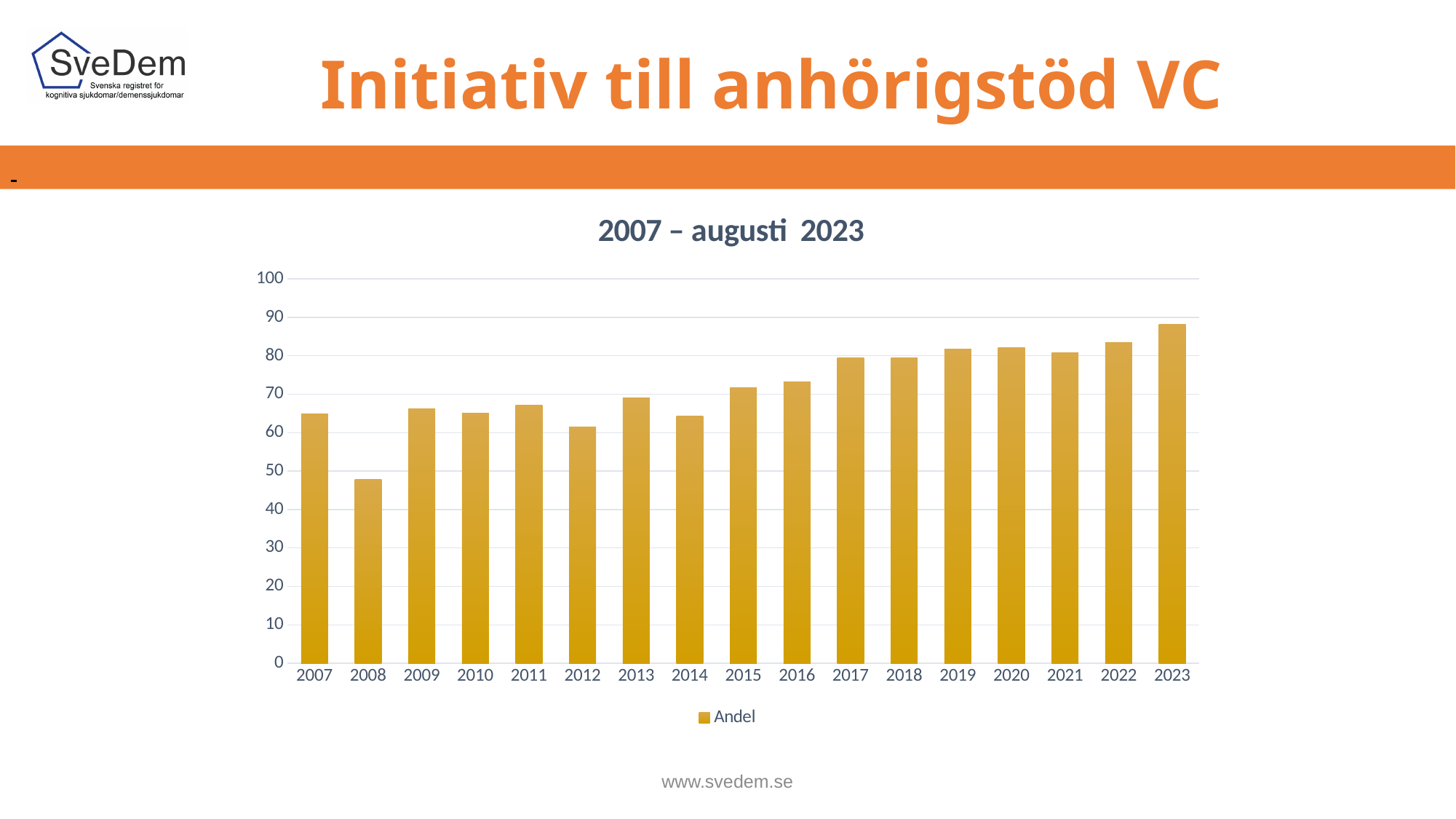
Is the value for 2012 greater or less than 60? greater What kind of chart is shown on the slide? bar chart Do the values generally rise or fall from 2007 to 2023? rise How many series does the legend list? 1 Which year has the lowest bar? 2008 What is the name of the series shown in the legend? Andel How many years are shown on the x axis? 17 Which is larger, the value for 2013 or the value for 2014? 2013 Is the value for 2023 greater or less than 90? less Is the value for 2008 greater or less than 50? less Which year has the highest bar? 2023